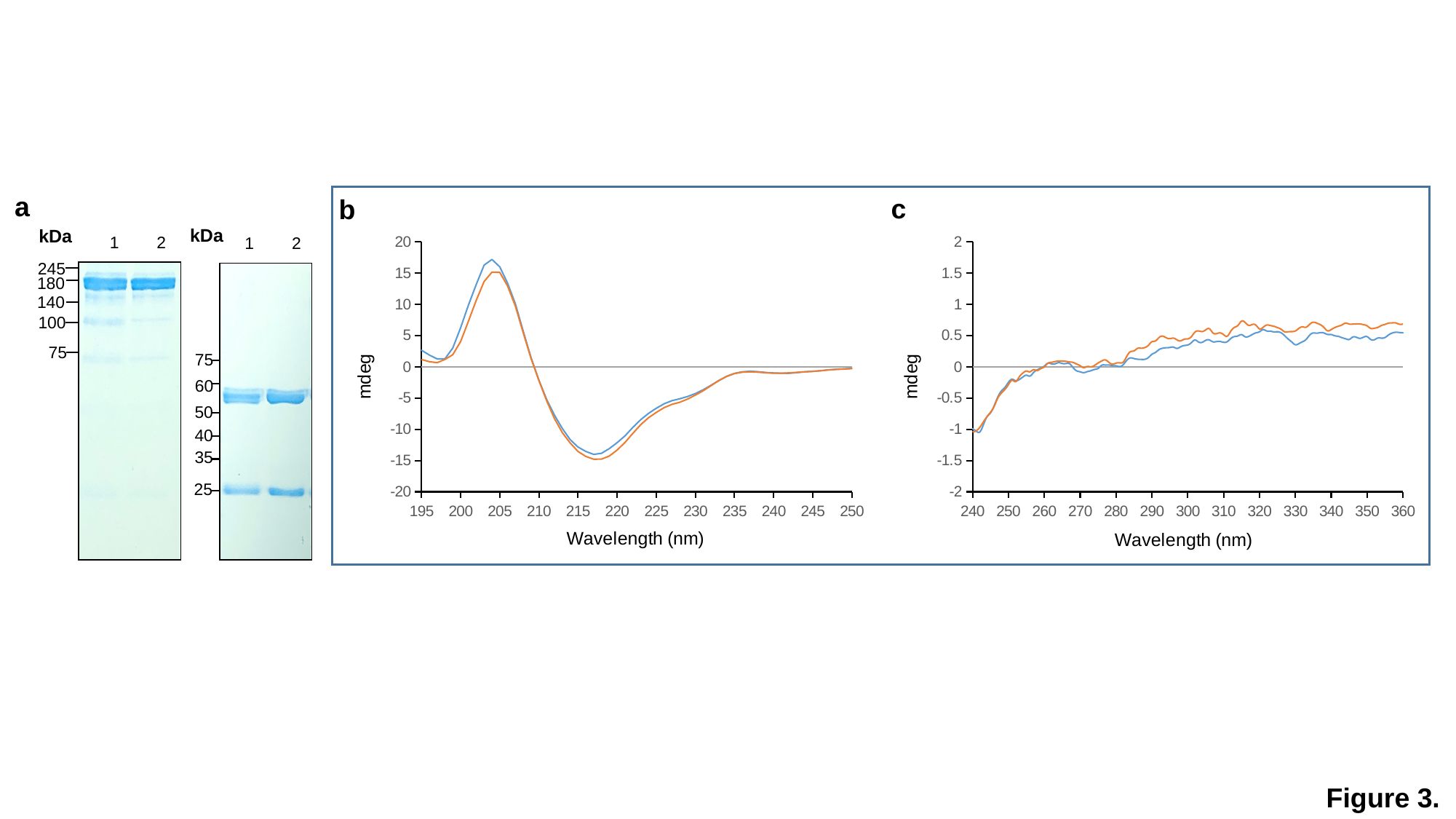
In chart b, at the peak near 205 nm, which line reaches the higher value, the blue or the orange? blue What kind of chart is chart b? line chart In chart b, is the value of the blue line at 205 nm greater or less than 10 mdeg? greater In chart c, do the values generally rise or fall as wavelength increases from 240 nm to 360 nm? rise In chart c, at 360 nm, which line has the higher value, the blue or the orange? orange How many lines are plotted in chart b? 2 What kind of chart is chart c? line chart In chart b, is the value of the blue line at 245 nm greater or less than -5 mdeg? greater In chart c, is the value of the orange line at 240 nm greater or less than -0.5 mdeg? less What is the x-axis label of chart c? Wavelength (nm)